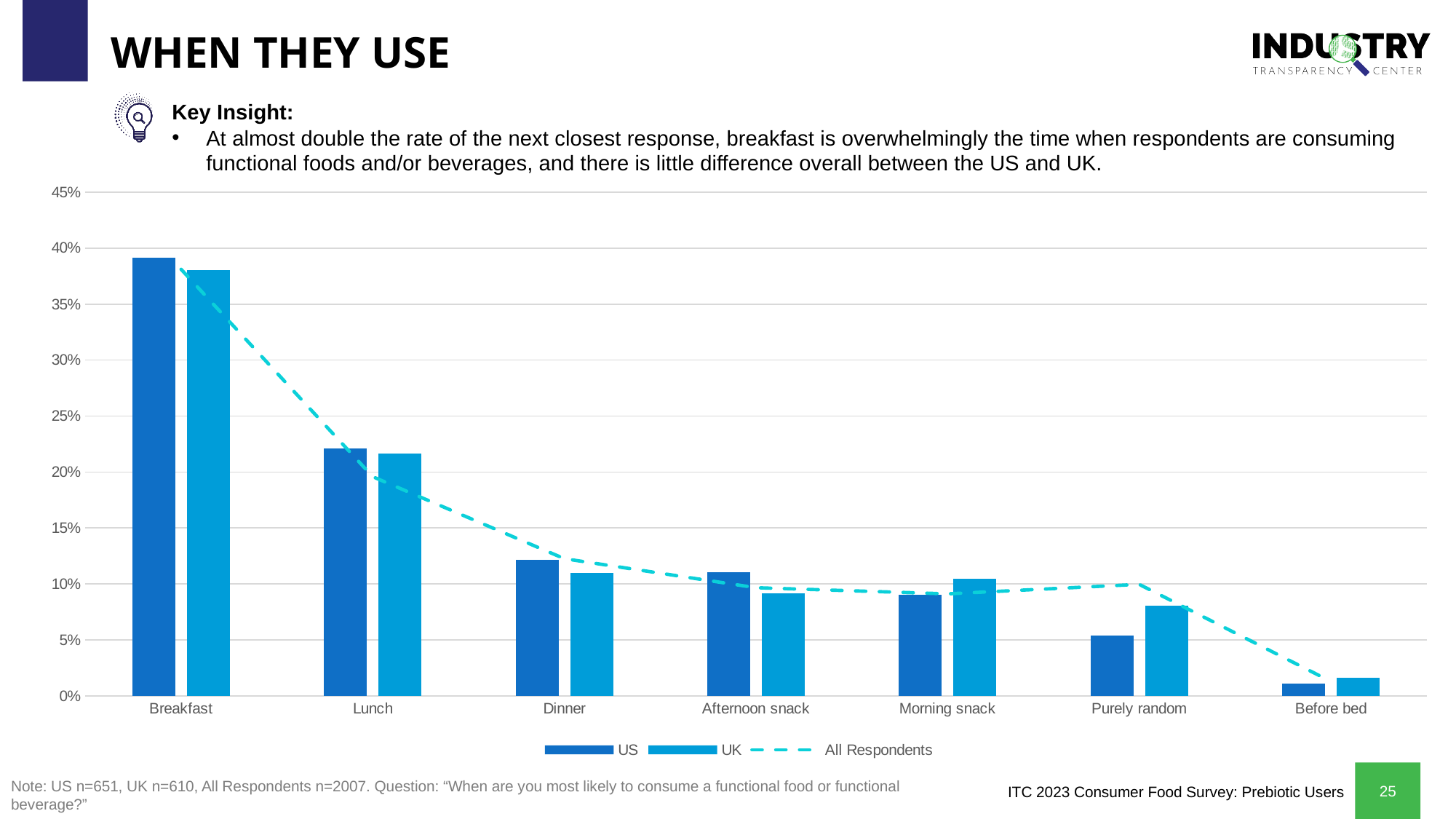
What kind of chart is shown on the slide? combination bar and line chart How many categories are shown along the x axis of the chart? 7 Does the All Respondents line generally rise or fall from Breakfast to Before bed? fall For Afternoon snack, which is larger: the US value or the UK value? US How many series does the chart's legend list? 3 Is the US value for Breakfast greater or less than 35%? greater Is the US value for Before bed greater or less than 5%? less Which legend entry is drawn as a dashed line rather than bars? All Respondents Which category has the lowest UK value? Before bed Which category has the highest US value? Breakfast Is the UK value for Lunch greater or less than 25%? less For Purely random, which is larger: the US value or the UK value? UK